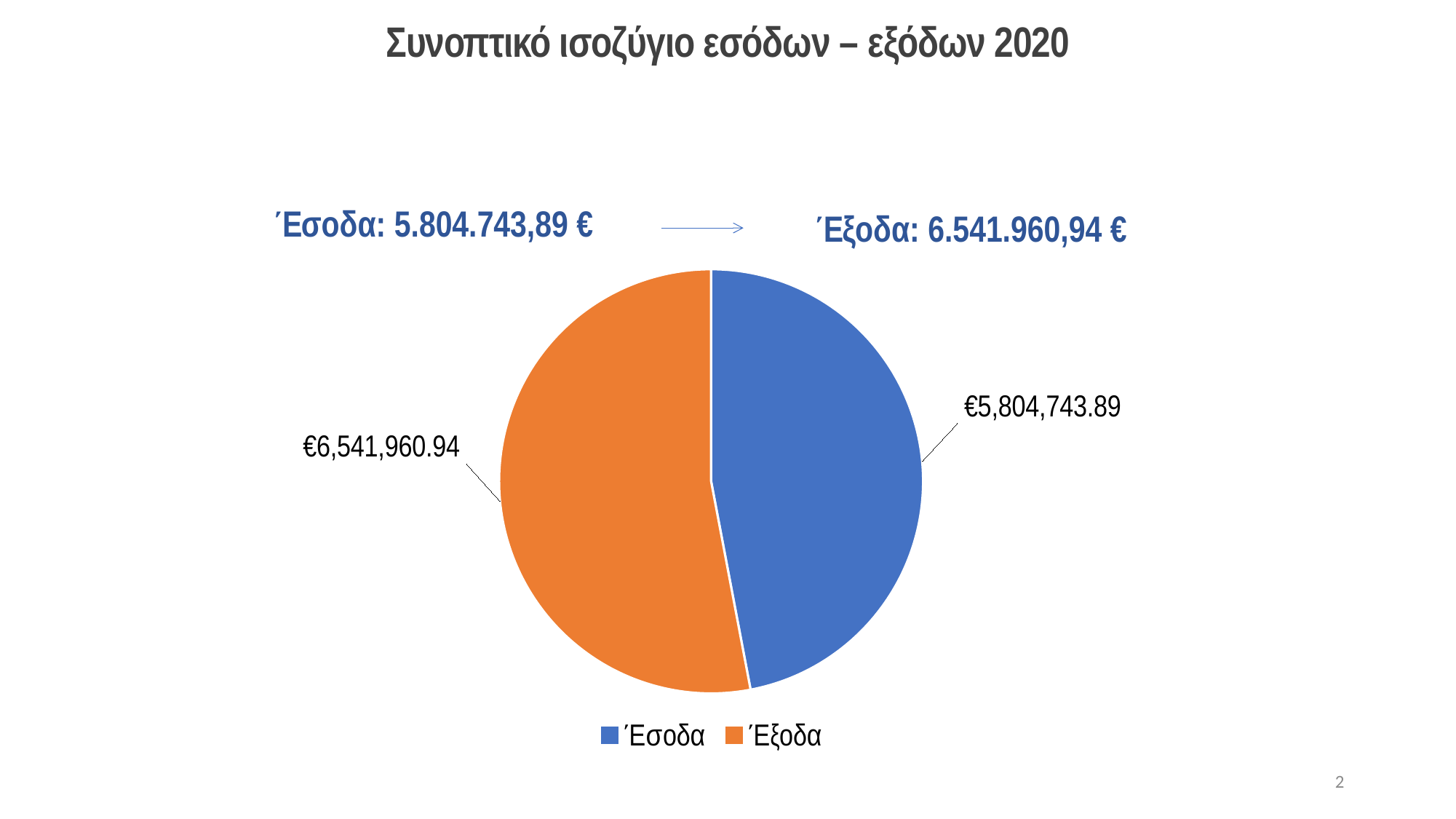
What is the value of the Έξοδα slice in the pie chart? €6,541,960.94 What is the combined total of the two slices in the pie chart? €12,346,704.83 What colour is the Έξοδα slice in the pie chart? orange Which slice of the pie chart is larger, Έσοδα or Έξοδα? Έξοδα What share of the pie does the Έξοδα slice represent, to one decimal place? 53.0% How many entries does the legend of the pie chart list? 2 How many slices does the pie chart have? 2 Which category has the smallest slice in the pie chart? Έσοδα What kind of chart is shown on the slide? pie chart What is the difference between the Έξοδα value and the Έσοδα value in the pie chart? €737,217.05 What is the value of the Έσοδα slice in the pie chart? €5,804,743.89 Which category has the largest slice in the pie chart? Έξοδα